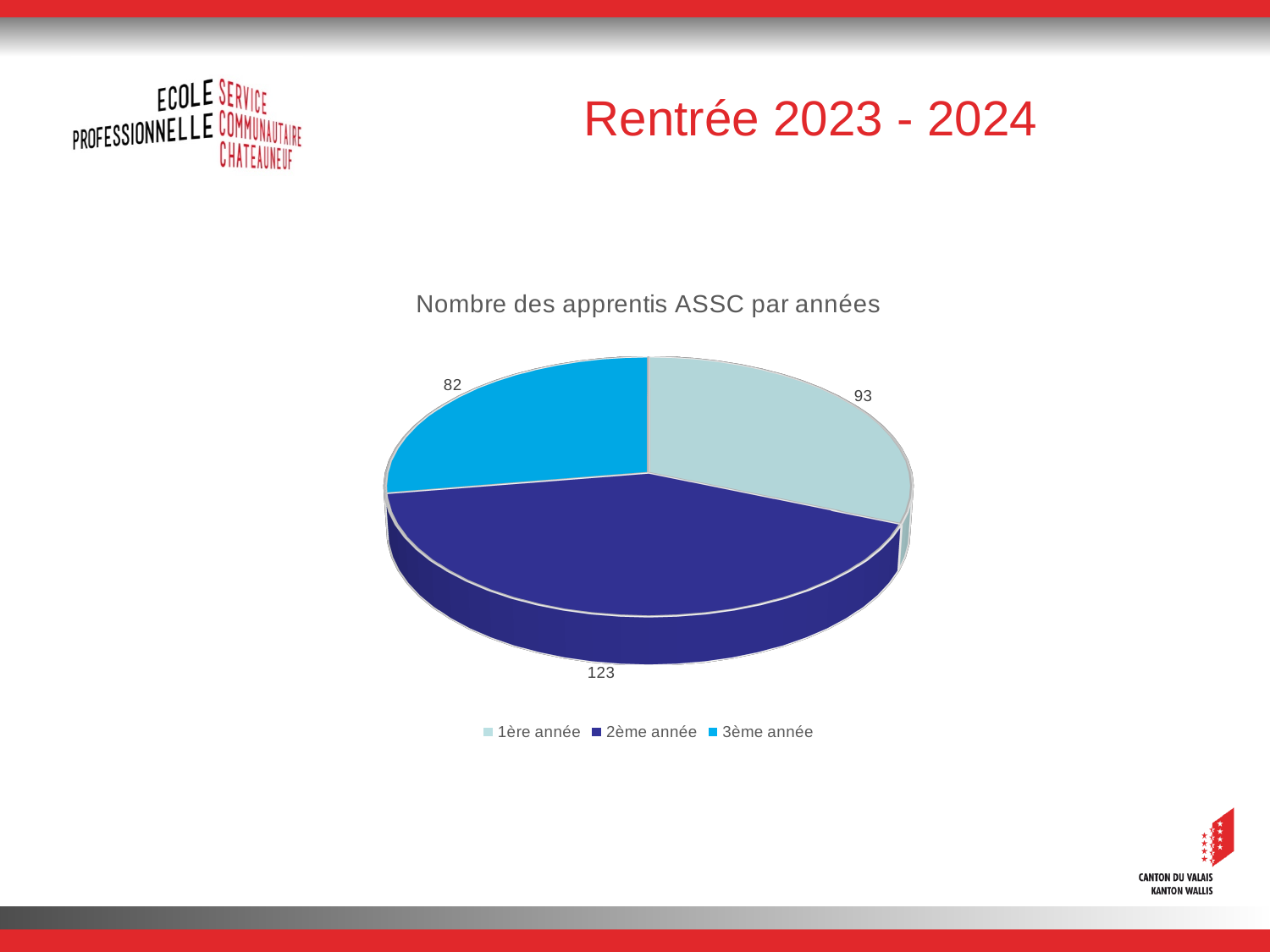
What is the total number of apprentices across all three years? 298 What is the value for 3ème année? 82 What kind of chart is shown on the slide? pie chart What is the value for 1ère année? 93 How many entries does the legend list? 3 Which year has the lowest number of apprentices? 3ème année How many slices does the pie chart have? 3 Which is larger, the value for 1ère année or the value for 3ème année? 1ère année What is the value for 2ème année? 123 What is the difference between the values for 2ème année and 1ère année? 30 What is the title of the chart? Nombre des apprentis ASSC par années Which year has the highest number of apprentices? 2ème année